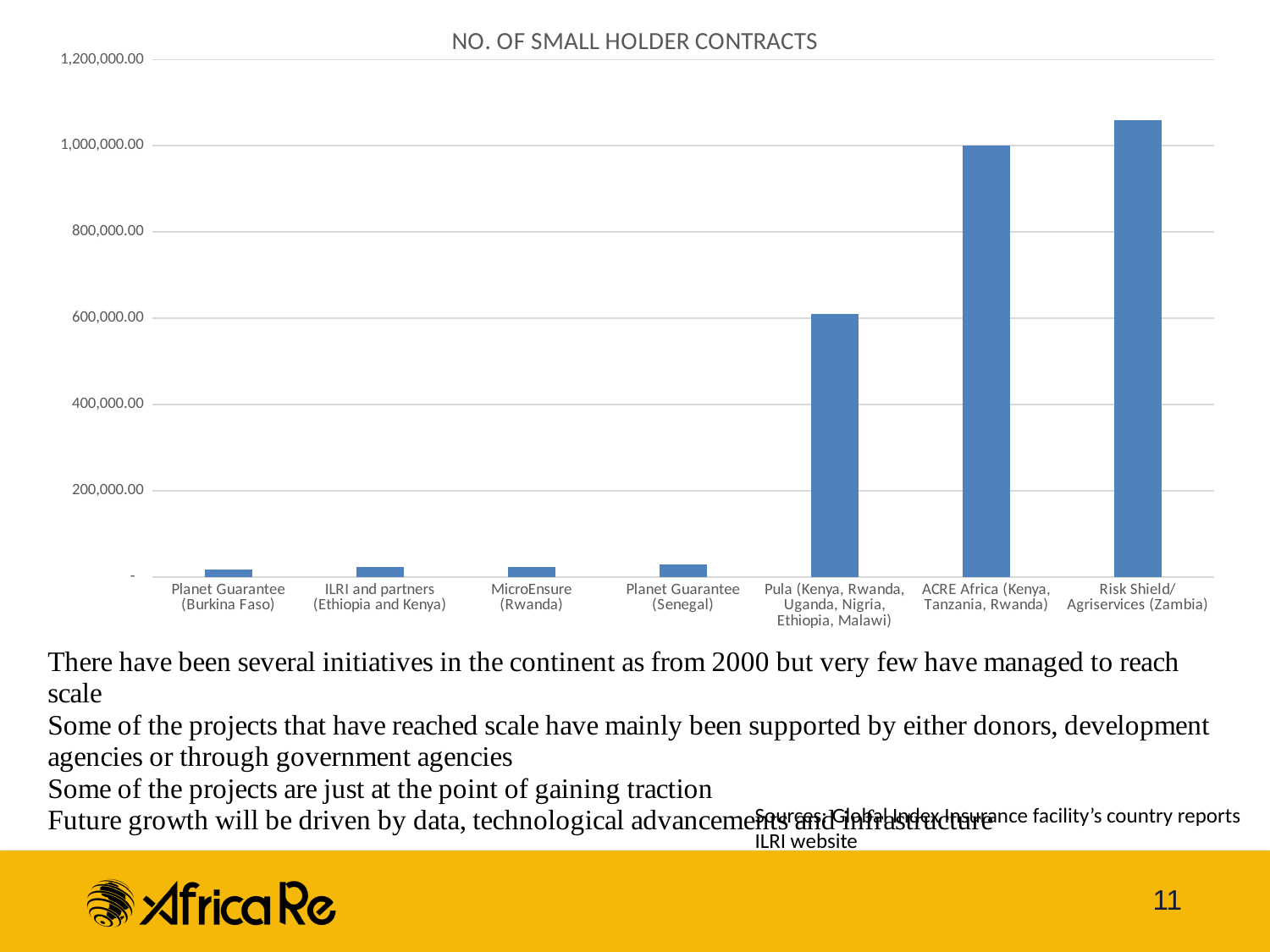
How many categories are shown on the x axis of the chart? 7 Which category has the highest number of small holder contracts? Risk Shield/ Agriservices (Zambia) Is the value for Risk Shield/ Agriservices (Zambia) greater or less than 1,000,000.00? greater Is the value for Pula (Kenya, Rwanda, Uganda, Nigria, Ethiopia, Malawi) greater or less than 800,000.00? less Which has more small holder contracts, Pula (Kenya, Rwanda, Uganda, Nigria, Ethiopia, Malawi) or ACRE Africa (Kenya, Tanzania, Rwanda)? ACRE Africa (Kenya, Tanzania, Rwanda) Is the value for MicroEnsure (Rwanda) greater or less than 200,000.00? less Which has more small holder contracts, ILRI and partners (Ethiopia and Kenya) or Risk Shield/ Agriservices (Zambia)? Risk Shield/ Agriservices (Zambia) What is the title of the chart? NO. OF SMALL HOLDER CONTRACTS What is the highest value shown on the y axis of the chart? 1,200,000.00 What kind of chart is shown on the slide? bar chart